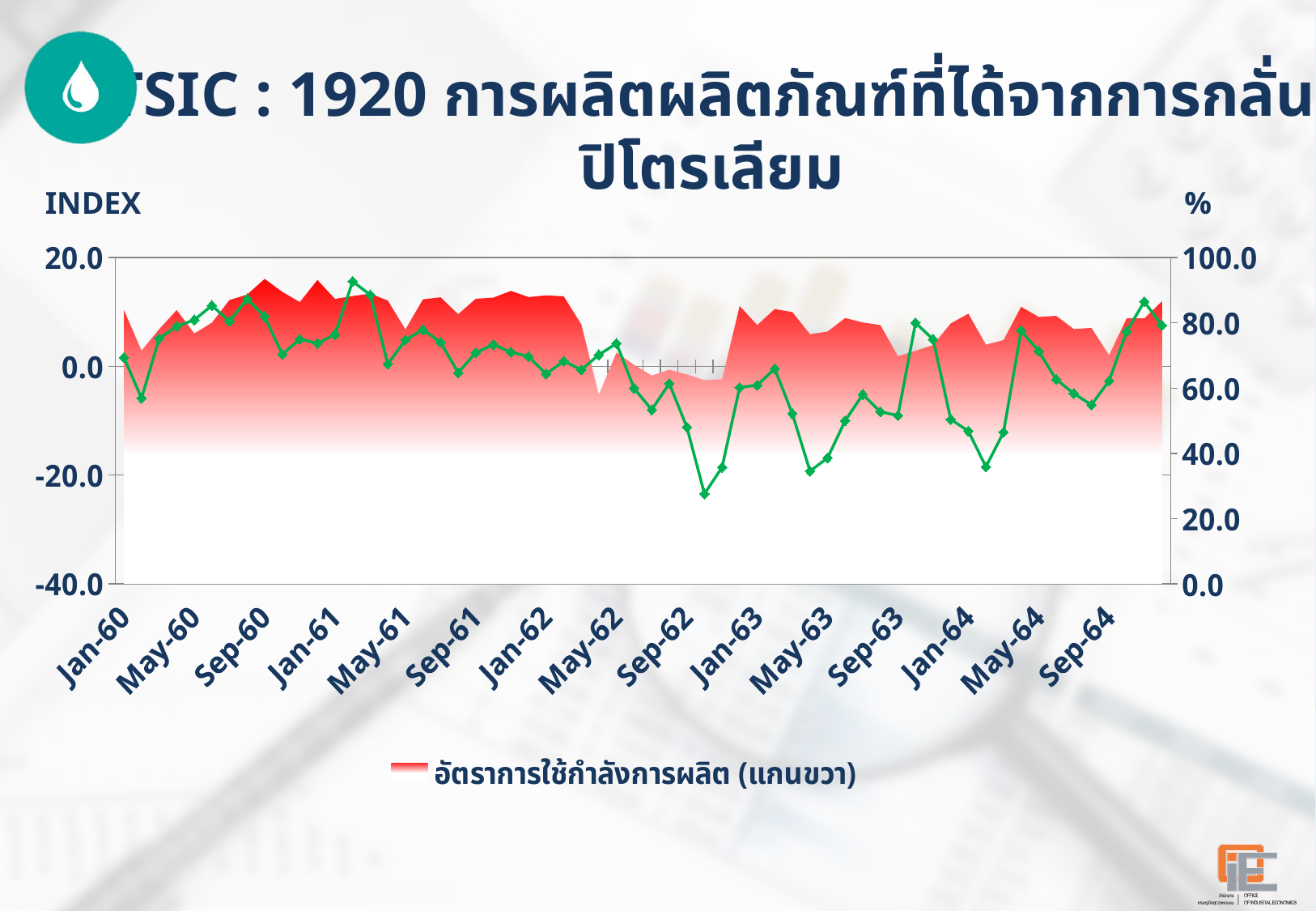
What kind of chart is shown on the slide? A combination chart with a red area series and a green line series What is the lowest value shown on the left (INDEX) axis? -40.0 How many entries does the legend list? 1 What is the label of the left vertical axis? INDEX What is the highest value shown on the right (%) axis? 100.0 How many labels are shown on the x axis? 15 Is the green line value at Sep-60 greater or less than 0.0 on the left axis? greater Is the green line value at May-63 greater or less than -10.0 on the left axis? less Is the red area value at Jan-60 greater or less than 60.0 on the right axis? greater Between which two x-axis labels does the green line reach its lowest point? Between Sep-62 and Jan-63 Between Jan-62 and Sep-62, does the red area rise or fall? fall What is the legend entry shown below the chart? อัตราการใช้กำลังการผลิต (แกนขวา)